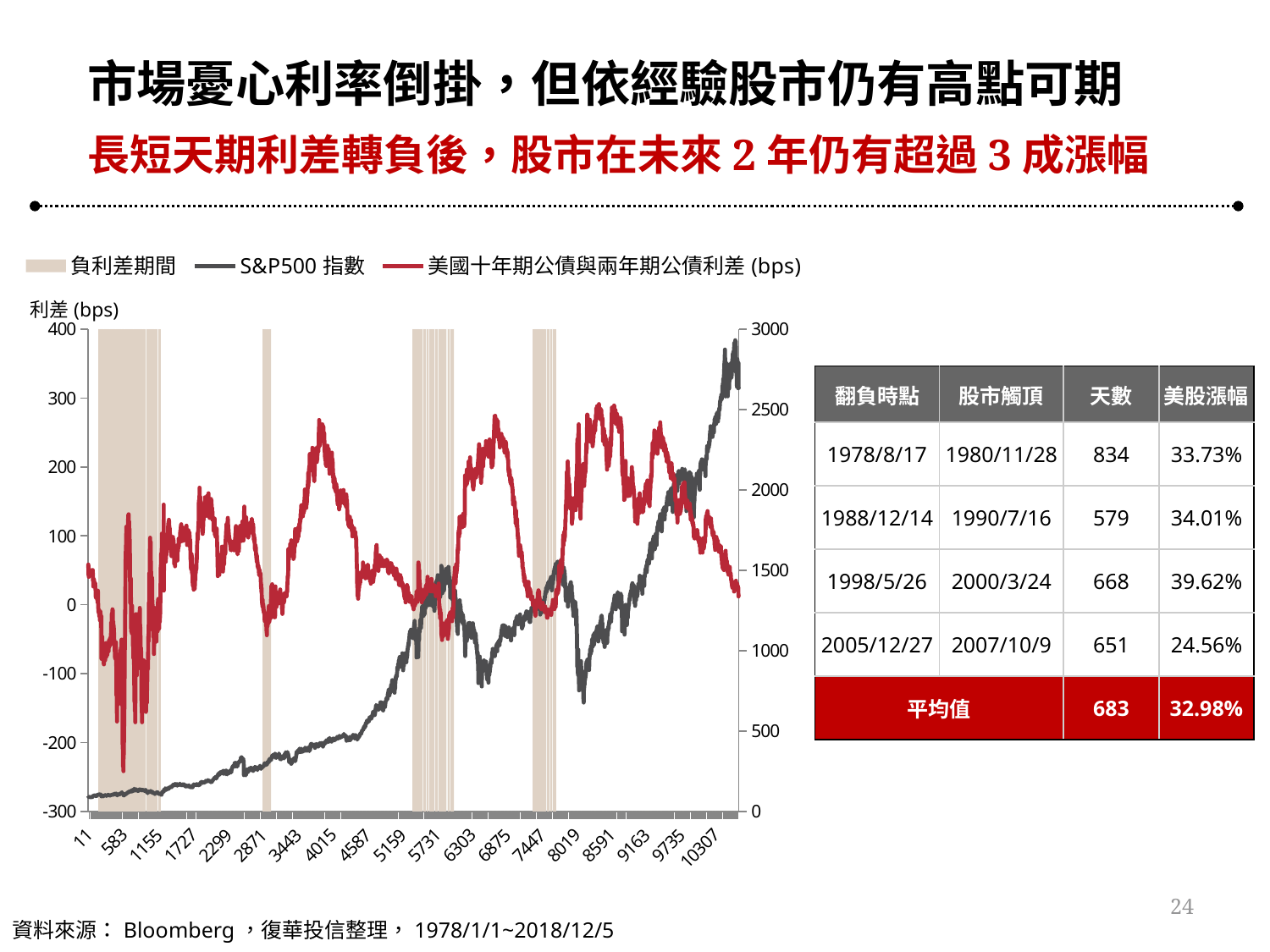
What kind of chart is shown on the slide? line chart Is the value of the S&P500 指數 series at the left end of the chart greater or less than 500? less What is the highest tick value shown on the right vertical axis of the chart? 3000 How many entries does the chart legend list? 3 What is the label of the left vertical axis of the chart? 利差 (bps) Is the lowest value reached by the 美國十年期公債與兩年期公債利差 series greater or less than -200? less Is the highest value reached by the 美國十年期公債與兩年期公債利差 series greater or less than 200? greater What is the lowest tick value shown on the left vertical axis of the chart? -300 Does the S&P500 指數 series generally rise or fall from left to right across the chart? rise Is the S&P500 指數 value larger at the left end or at the right end of the chart? right end